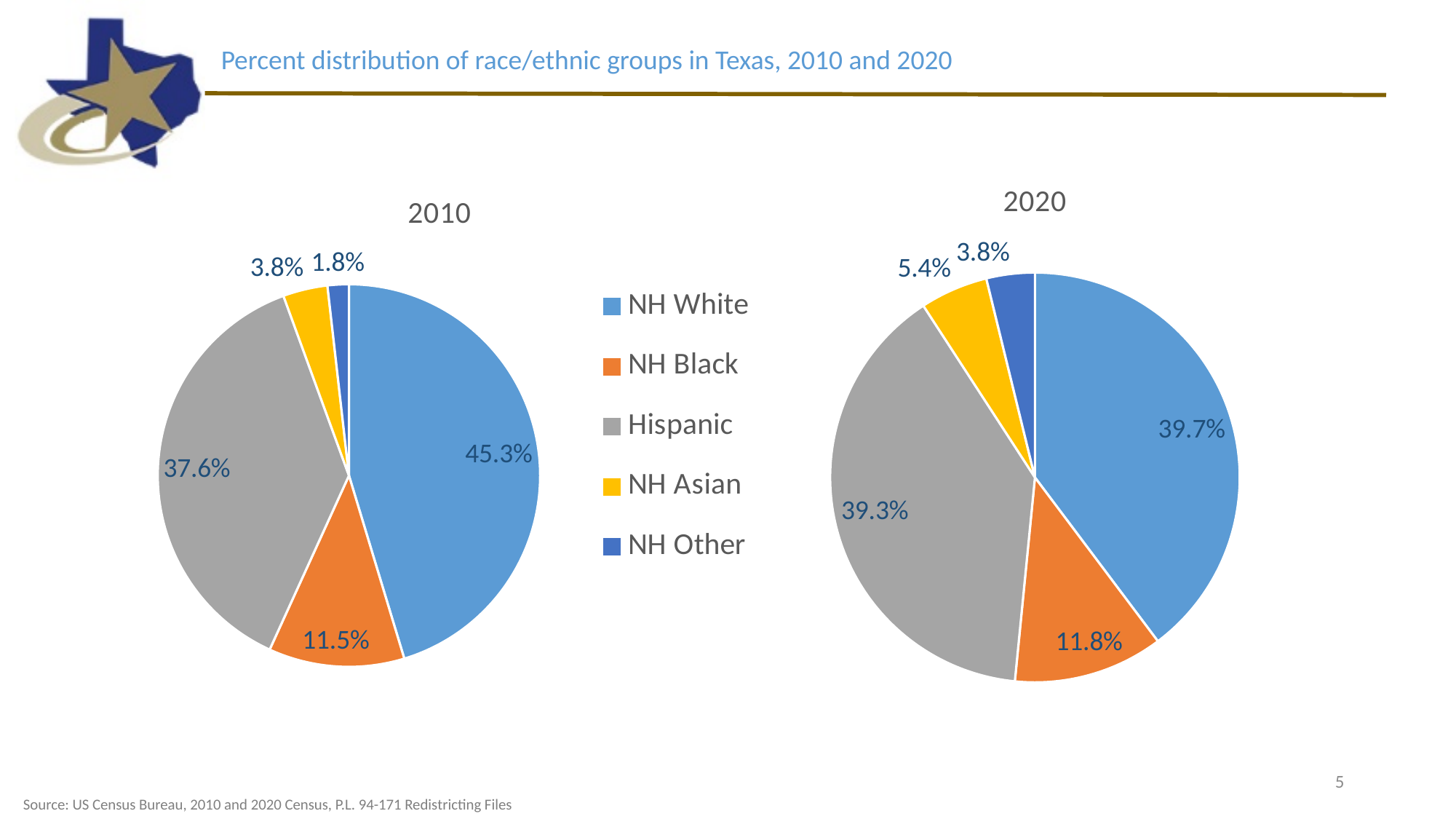
In the 2010 pie chart, which group has the smallest share? NH Other In the 2020 pie chart, which group has the smallest share? NH Other What kind of chart is used for the 2010 data? Pie chart In the 2020 pie chart, what is the share for NH Asian? 5.4% What is the difference between the NH White share in 2010 and in 2020? 5.6% In the 2020 pie chart, what is the share for Hispanic? 39.3% How many groups are shown in the 2020 pie chart? 5 Which colour represents Hispanic in the legend? Grey In the 2010 pie chart, what is the share for NH Other? 1.8% In the 2010 pie chart, which group has the largest share? NH White In the 2010 pie chart, which is larger, the share for NH Black or the share for NH Asian? NH Black In the 2010 pie chart, what is the share for NH White? 45.3%